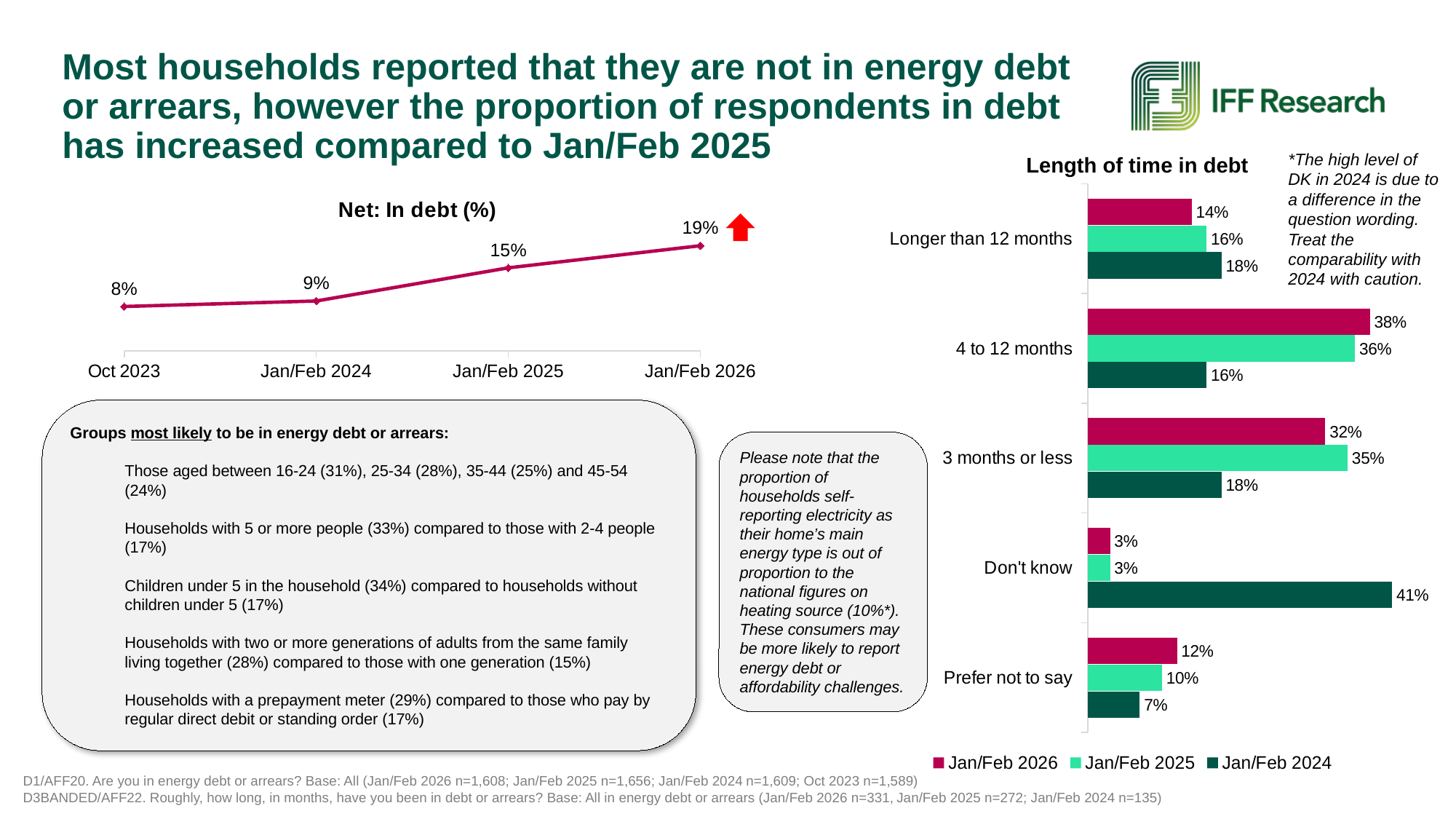
In the 'Length of time in debt' chart, what is the Jan/Feb 2024 value for 'Don't know'? 41% What kind of chart is the 'Length of time in debt' chart? bar chart In the 'Length of time in debt' chart, what is the Jan/Feb 2026 value for '4 to 12 months'? 38% In the 'Net: In debt (%)' chart, how many time points are plotted? 4 What kind of chart is the 'Net: In debt (%)' chart? line chart In the 'Net: In debt (%)' chart, do the values rise or fall from Oct 2023 to Jan/Feb 2026? rise In the 'Length of time in debt' chart, which is larger for '3 months or less': Jan/Feb 2026 or Jan/Feb 2025? Jan/Feb 2025 In the 'Net: In debt (%)' chart, what is the value for Oct 2023? 8% How many series does the legend of the 'Length of time in debt' chart list? 3 In the 'Net: In debt (%)' chart, what is the difference between the Jan/Feb 2026 and Jan/Feb 2025 values? 4 percentage points In the 'Net: In debt (%)' chart, what is the value for Jan/Feb 2026? 19% In the 'Length of time in debt' chart, which category has the lowest Jan/Feb 2025 value? Don't know